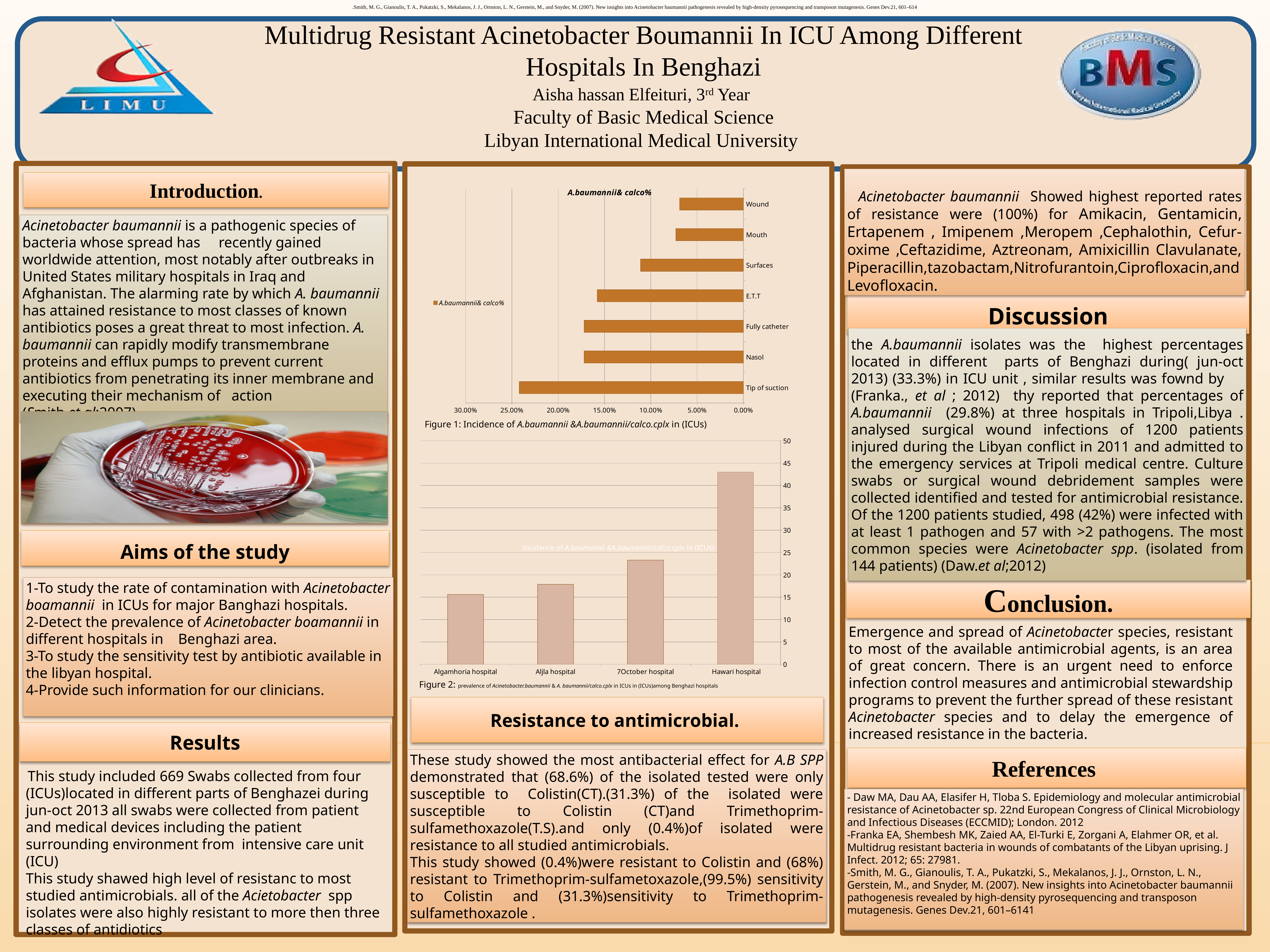
In Figure 1 (A.baumannii& calco%), how many categories are plotted? 7 In Figure 1 (A.baumannii& calco%), is the value for Surfaces greater or less than 15.00%? less In Figure 1 (A.baumannii& calco%), is the value for Tip of suction greater or less than 20.00%? greater In Figure 2 (prevalence among Benghazi hospitals), is the value for 7October hospital greater or less than 20? greater In Figure 2 (prevalence among Benghazi hospitals), which hospital has the lowest value? Algamhoria hospital In Figure 2 (prevalence among Benghazi hospitals), which hospital has the highest value? Hawari hospital In Figure 1 (A.baumannii& calco%), which is larger, the value for Surfaces or the value for Tip of suction? Tip of suction What type of chart is Figure 1 (A.baumannii& calco%)? bar chart In Figure 2 (prevalence among Benghazi hospitals), how many hospitals are plotted? 4 In Figure 1 (A.baumannii& calco%), which category has the highest value? Tip of suction